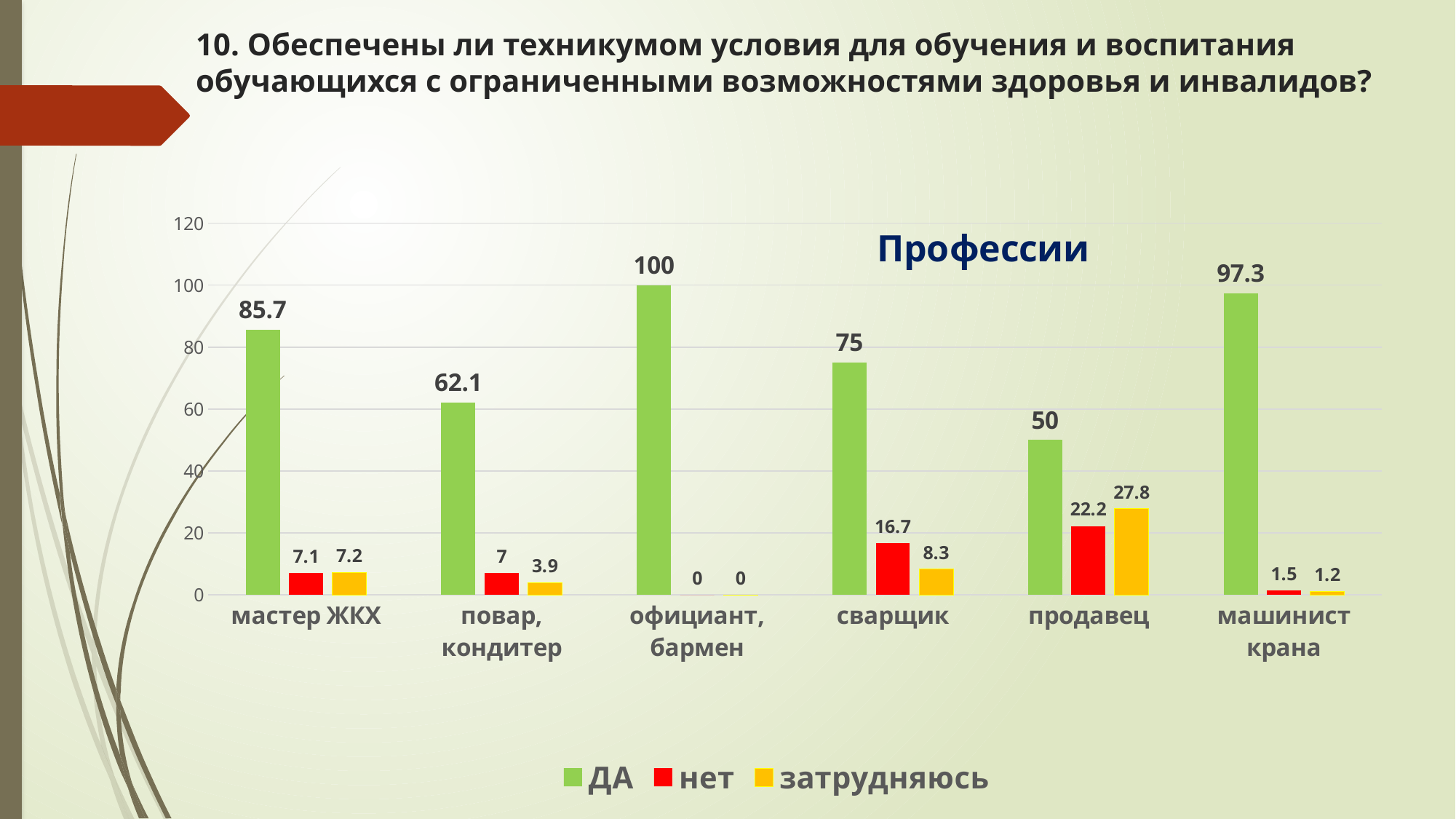
What kind of chart is shown on the slide? bar chart What is the value of the затрудняюсь series for повар, кондитер? 3.9 What is the value of the нет series for продавец? 22.2 Which category has the highest value in the ДА series? официант, бармен What is the title shown inside the chart area? Профессии Which category has the lowest value in the ДА series? продавец What is the value of the ДА series for сварщик? 75 What colour represents the нет series? red How many categories are shown on the x axis? 6 What is the difference between the ДА values for машинист крана and мастер ЖКХ? 11.6 How many series does the legend list? 3 Which is larger for продавец: the нет value or the затрудняюсь value? затрудняюсь